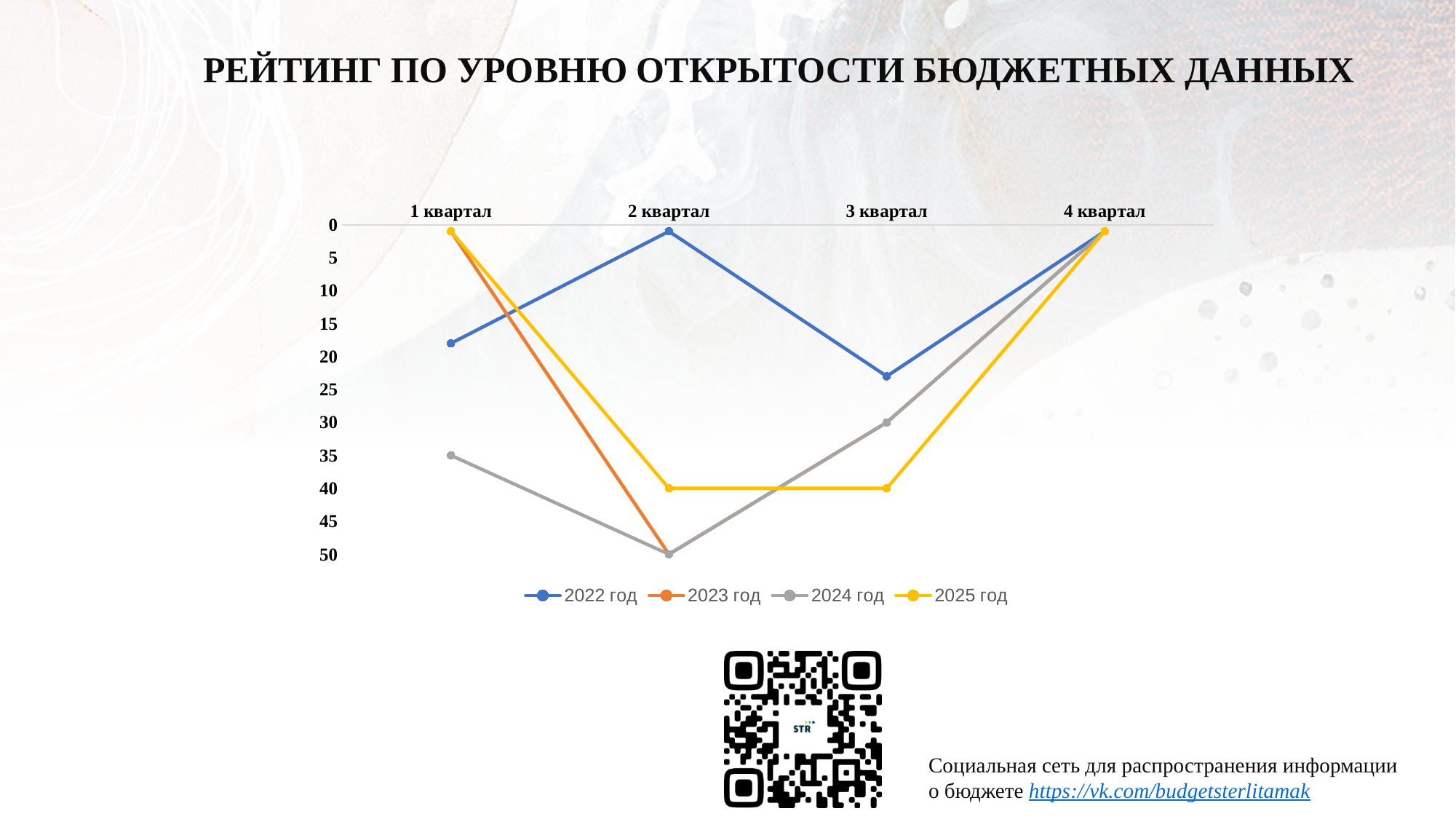
What is the difference between the 2024 год values in 2 квартал and 3 квартал? 20 How many series does the legend list? 4 Is the value for 2022 год in 3 квартал greater or less than 20? greater How many quarters (categories) are shown on the x axis? 4 What is the value for 2024 год in 1 квартал? 35 What is the value for 2025 год in 2 квартал? 40 In 2 квартал, which series has the larger value: 2024 год or 2025 год? 2024 год What is the value for 2023 год in 2 квартал? 50 What is the title of the chart on the slide? РЕЙТИНГ ПО УРОВНЮ ОТКРЫТОСТИ БЮДЖЕТНЫХ ДАННЫХ What kind of chart is shown on the slide? line chart What is the value for 2024 год in 3 квартал? 30 Is the value for 2022 год in 1 квартал greater or less than 10? greater